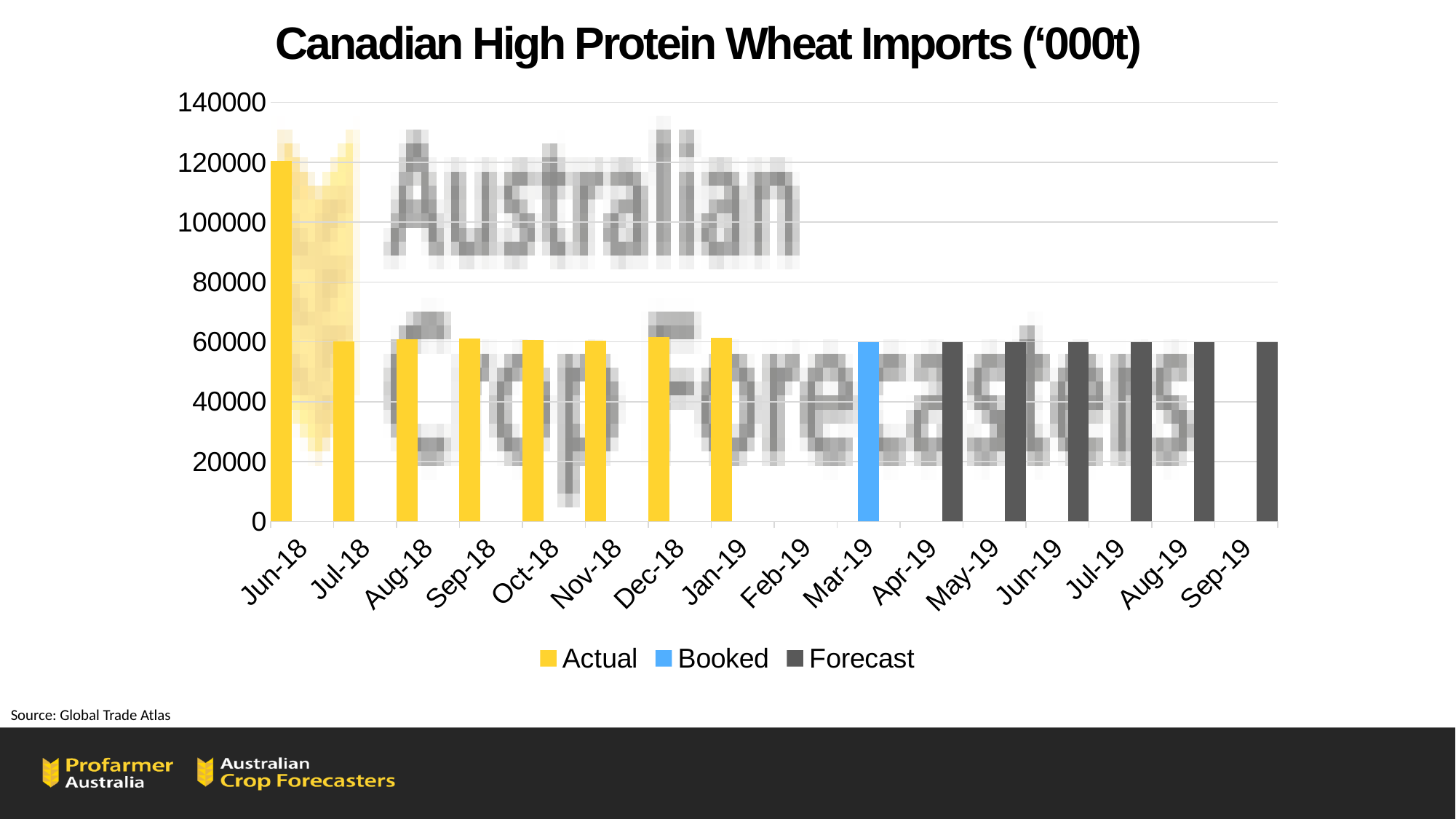
Is the value for Dec-18 greater or less than 40000? greater Which month on the x axis has no bar plotted? Feb-19 Is the value for Jul-18 greater or less than 80000? less Which is larger, the value for Jun-18 or the value for Jul-18? Jun-18 What are the three series named in the legend? Actual, Booked, Forecast What kind of chart is shown on the slide? bar chart How many months are shown on the x axis? 16 Which series does the Mar-19 bar belong to? Booked Is the value for Jun-18 greater or less than 100000? greater How many series does the legend list? 3 Which month has the highest value? Jun-18